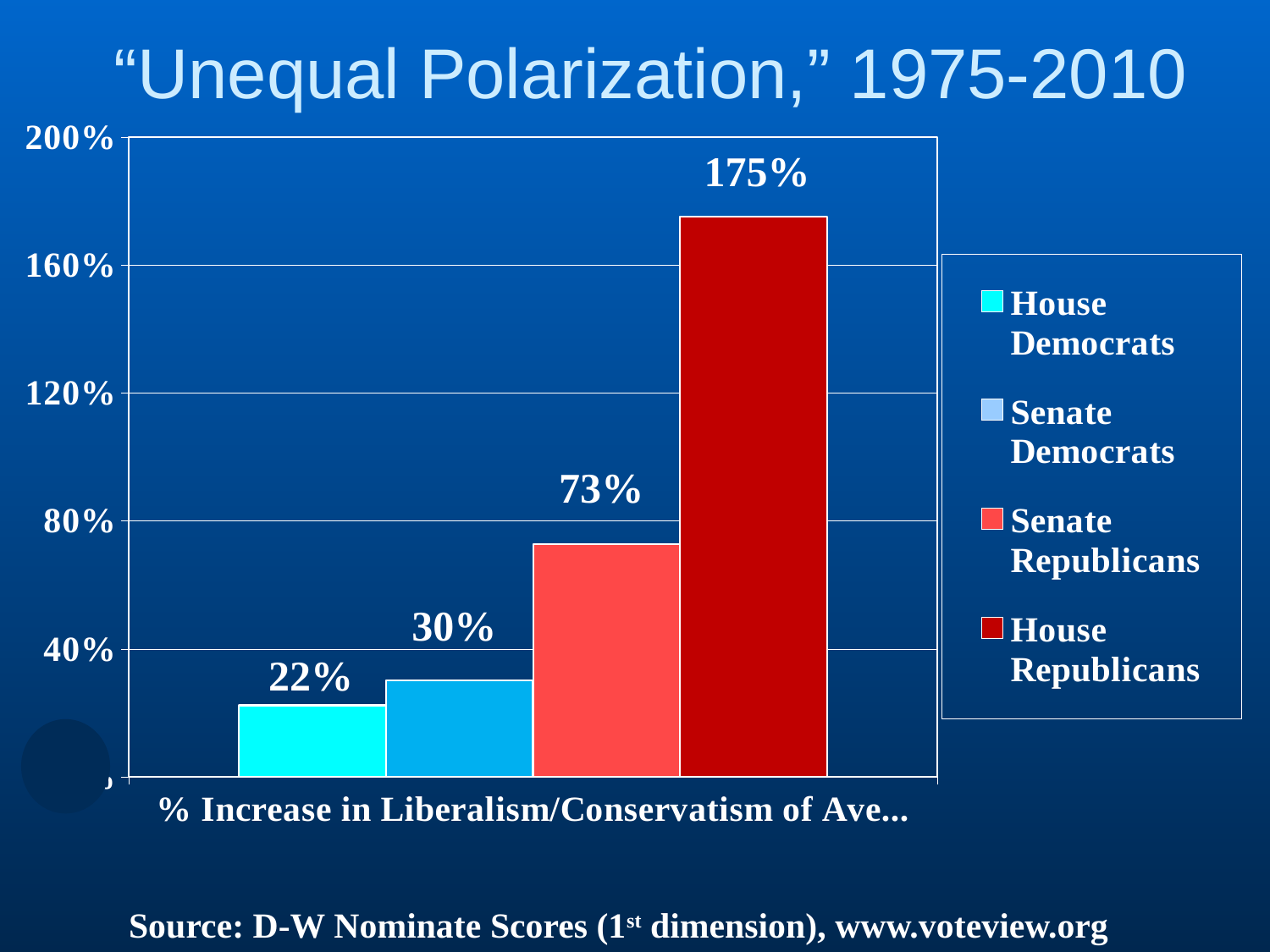
What is the title of the slide? "Unequal Polarization," 1975-2010 What kind of chart is shown on the slide? Bar chart What is the value for House Republicans? 175% What is the value for Senate Republicans? 73% What is the value for Senate Democrats? 30% What is the difference between the values for House Republicans and Senate Republicans? 102% Which series has the highest value? House Republicans What is the value for House Democrats? 22% Which is larger, the value for Senate Republicans or the value for Senate Democrats? Senate Republicans Which series has the lowest value? House Democrats What is the difference between the values for Senate Democrats and House Democrats? 8% How many series does the legend list? 4